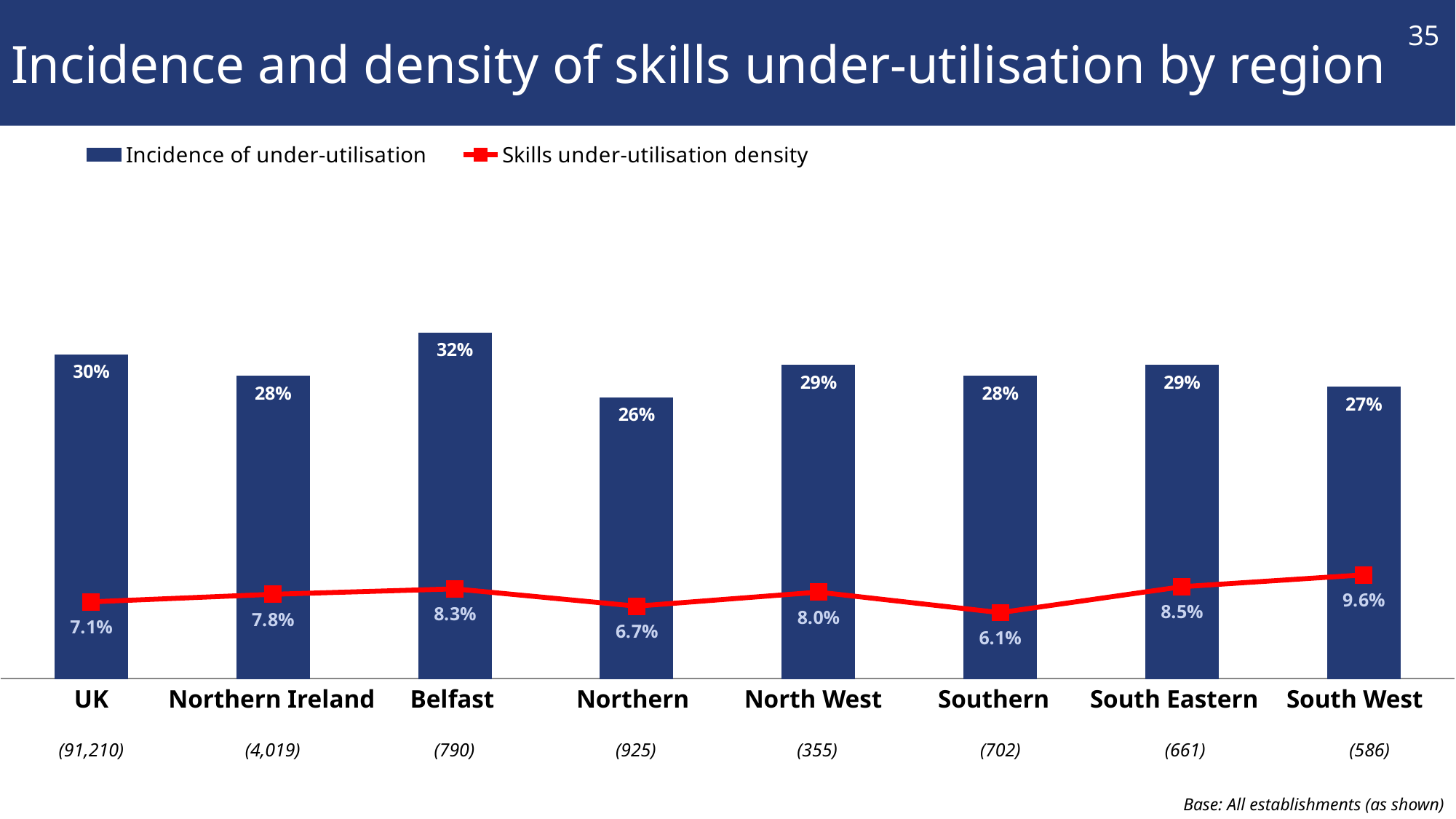
How many series does the legend list? 2 How many regions are shown on the x axis? 8 Which region has the highest incidence of under-utilisation? Belfast Which region has the lowest skills under-utilisation density? Southern What is the incidence of under-utilisation for Belfast? 32% What is the skills under-utilisation density for Southern? 6.1% Which region has the lowest incidence of under-utilisation? Northern Which has a higher skills under-utilisation density, Belfast or Northern Ireland? Belfast What is the skills under-utilisation density for South West? 9.6% What is the incidence of under-utilisation for the UK? 30% What is the base (number of establishments) shown for Northern Ireland? 4,019 What is the difference in incidence of under-utilisation between Belfast and Northern? 6 percentage points